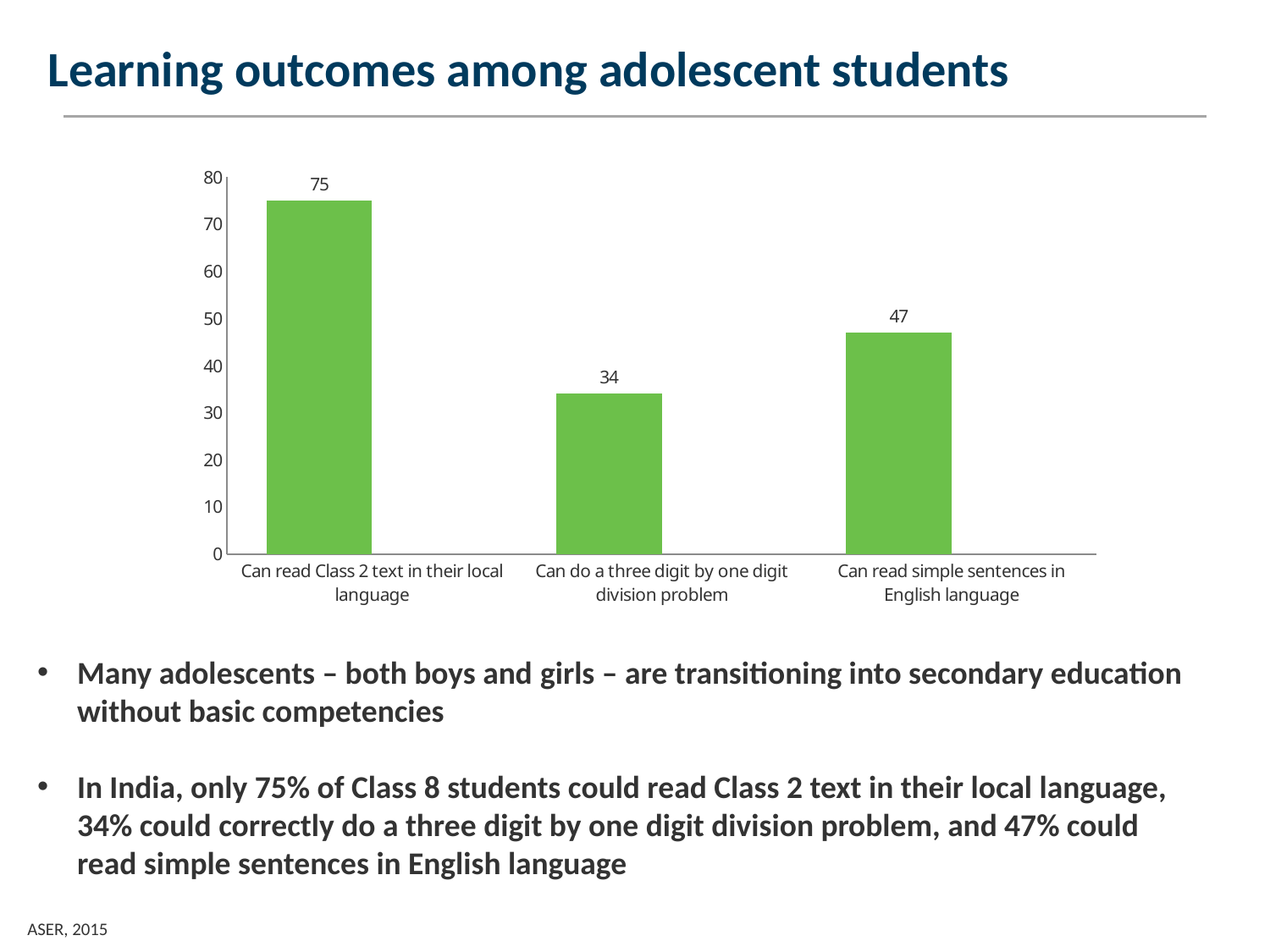
Which is larger: the value for 'Can read simple sentences in English language' or the value for 'Can do a three digit by one digit division problem'? Can read simple sentences in English language How many categories are shown in the chart? 3 What is the title of the slide containing the chart? Learning outcomes among adolescent students Is the value for 'Can read simple sentences in English language' greater or less than 40? greater What is the value for 'Can read simple sentences in English language'? 47 Which category has the highest value? Can read Class 2 text in their local language What is the difference between the value for 'Can read Class 2 text in their local language' and the value for 'Can do a three digit by one digit division problem'? 41 Which category has the lowest value? Can do a three digit by one digit division problem What is the difference between the value for 'Can read simple sentences in English language' and the value for 'Can do a three digit by one digit division problem'? 13 What is the value for 'Can read Class 2 text in their local language'? 75 What is the value for 'Can do a three digit by one digit division problem'? 34 What kind of chart is shown on the slide? Bar chart